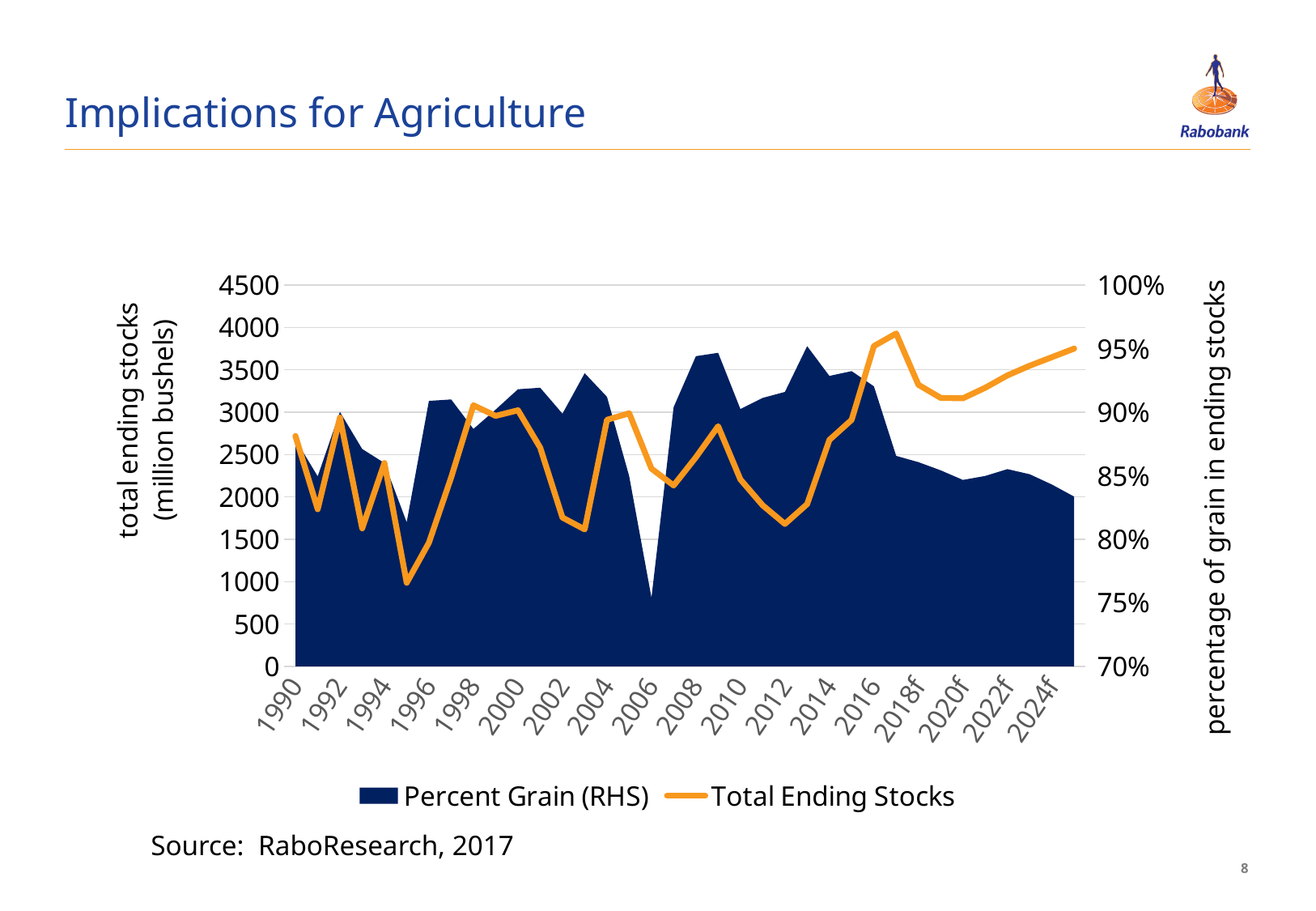
What kind of chart is shown on the slide? A combination area and line chart In which year does the dark blue area reach its lowest point? 2006 What is the title of the left vertical axis? total ending stocks (million bushels) What are the two series named in the legend? Percent Grain (RHS) and Total Ending Stocks Is the orange line value higher in 2017 or in 2012? 2017 How many series does the legend list? 2 In which year does the orange Total Ending Stocks line reach its lowest point? 1995 How many year labels are shown along the x axis? 18 In which year does the orange Total Ending Stocks line reach its highest point? 2017 Does the orange Total Ending Stocks line rise or fall from 2018f to 2024f? rise